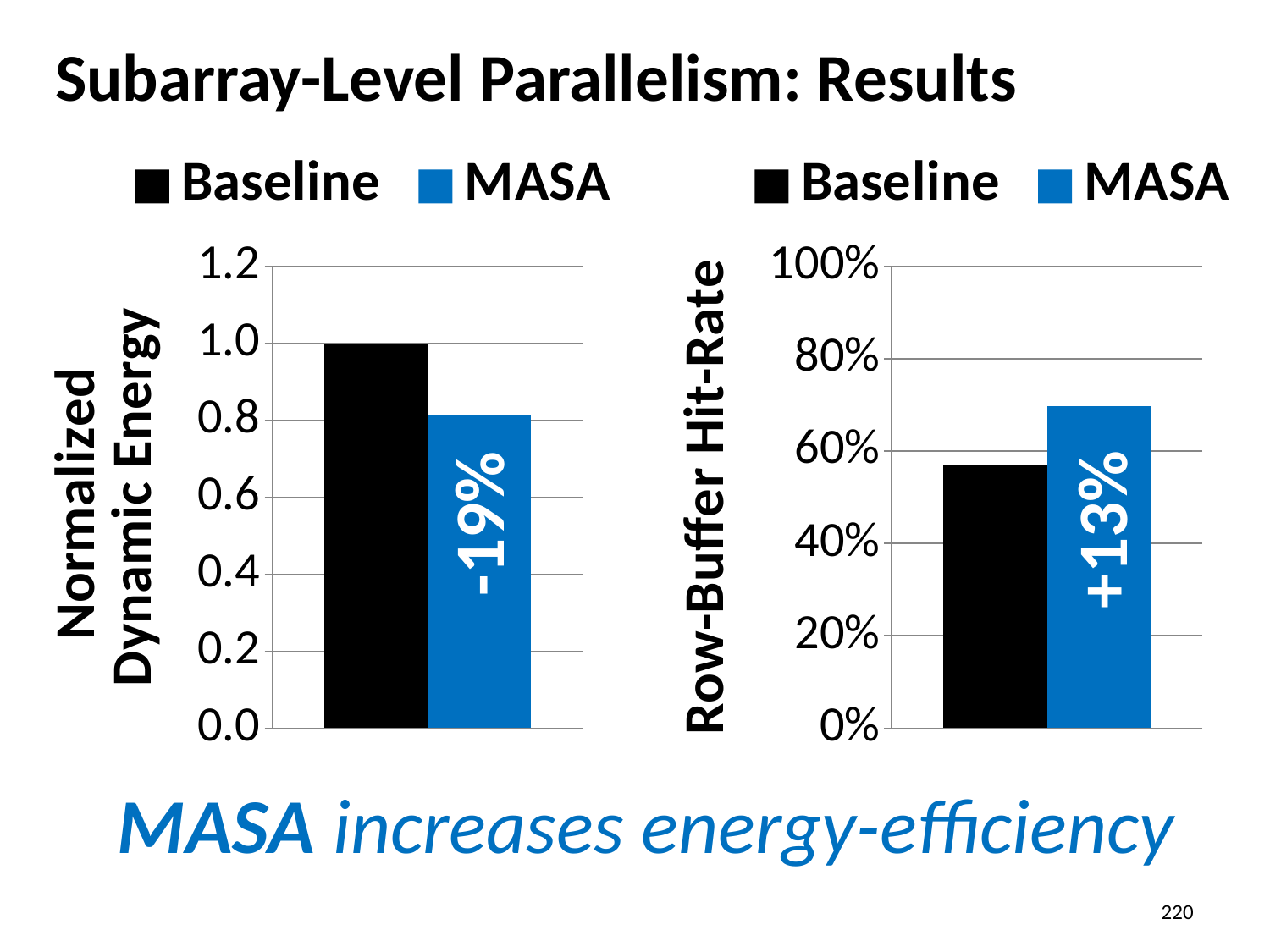
In the right chart (Row-Buffer Hit-Rate), which series has the higher value, Baseline or MASA? MASA In the left chart (Normalized Dynamic Energy), what is the value for Baseline? 1.0 What percentage change is printed on the MASA bar in the right chart (Row-Buffer Hit-Rate)? +13% In the left chart (Normalized Dynamic Energy), is the value for MASA greater or less than 0.6? greater How many series does the legend of the right chart (Row-Buffer Hit-Rate) list? 2 What kind of chart is the left chart (Normalized Dynamic Energy)? bar chart What percentage change is printed on the MASA bar in the left chart (Normalized Dynamic Energy)? -19% In the right chart (Row-Buffer Hit-Rate), is the value for MASA greater or less than 80%? less In the left chart (Normalized Dynamic Energy), is the value for MASA greater or less than 1.0? less In the left chart (Normalized Dynamic Energy), which series has the lower value, Baseline or MASA? MASA